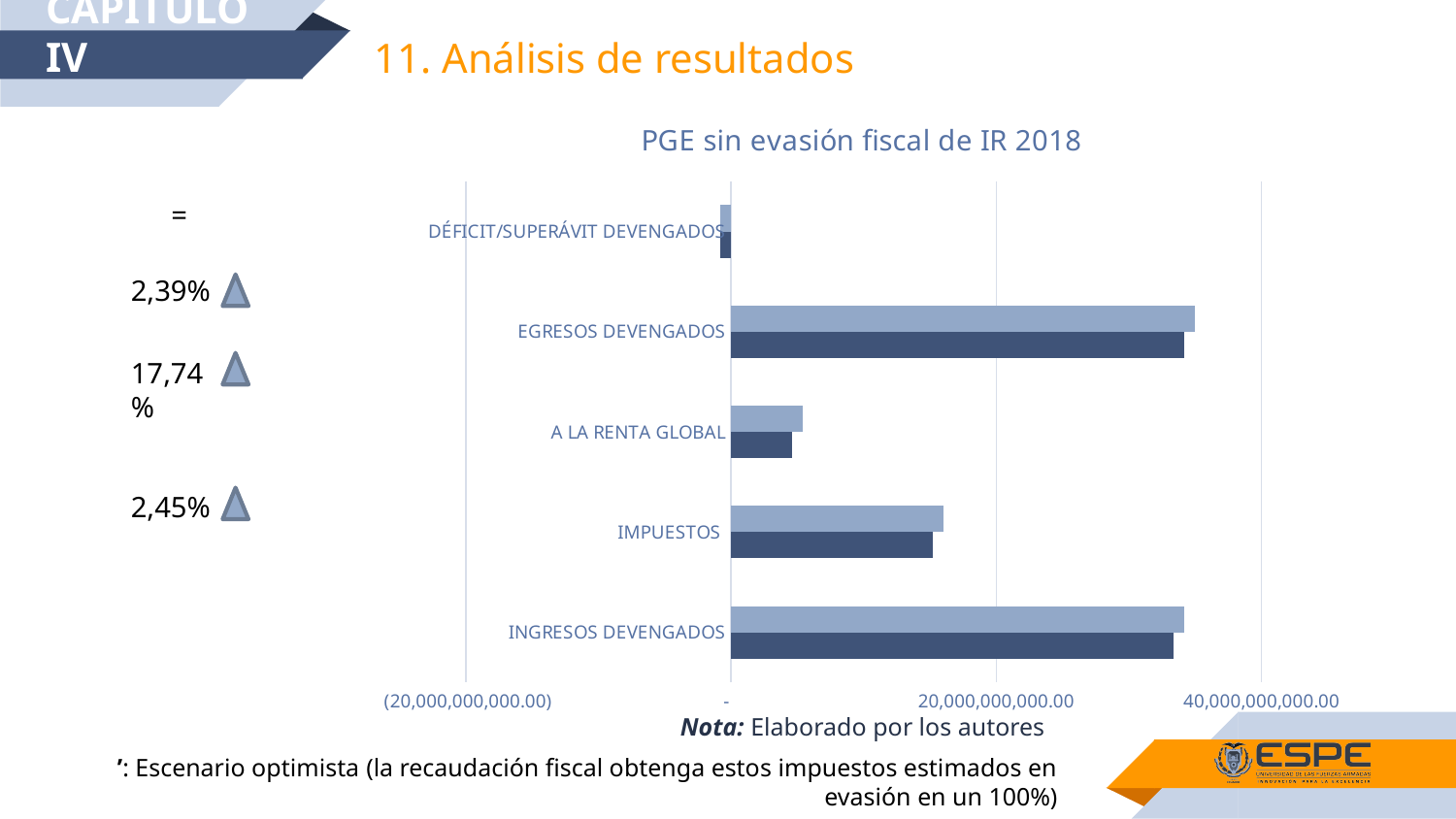
Which is larger, the value for EGRESOS DEVENGADOS or the value for IMPUESTOS? EGRESOS DEVENGADOS Is the value for INGRESOS DEVENGADOS greater or less than 20,000,000,000.00? greater What kind of chart is shown on the slide? Bar chart Which category has the lowest values on the chart? DÉFICIT/SUPERÁVIT DEVENGADOS How many bars are drawn for each category on the chart? 2 What is the title of the chart? PGE sin evasión fiscal de IR 2018 Is the value for EGRESOS DEVENGADOS greater or less than 20,000,000,000.00? greater Is the value for IMPUESTOS greater or less than 20,000,000,000.00? less How many categories are shown on the chart's vertical axis? 5 Which is larger, the value for IMPUESTOS or the value for A LA RENTA GLOBAL? IMPUESTOS